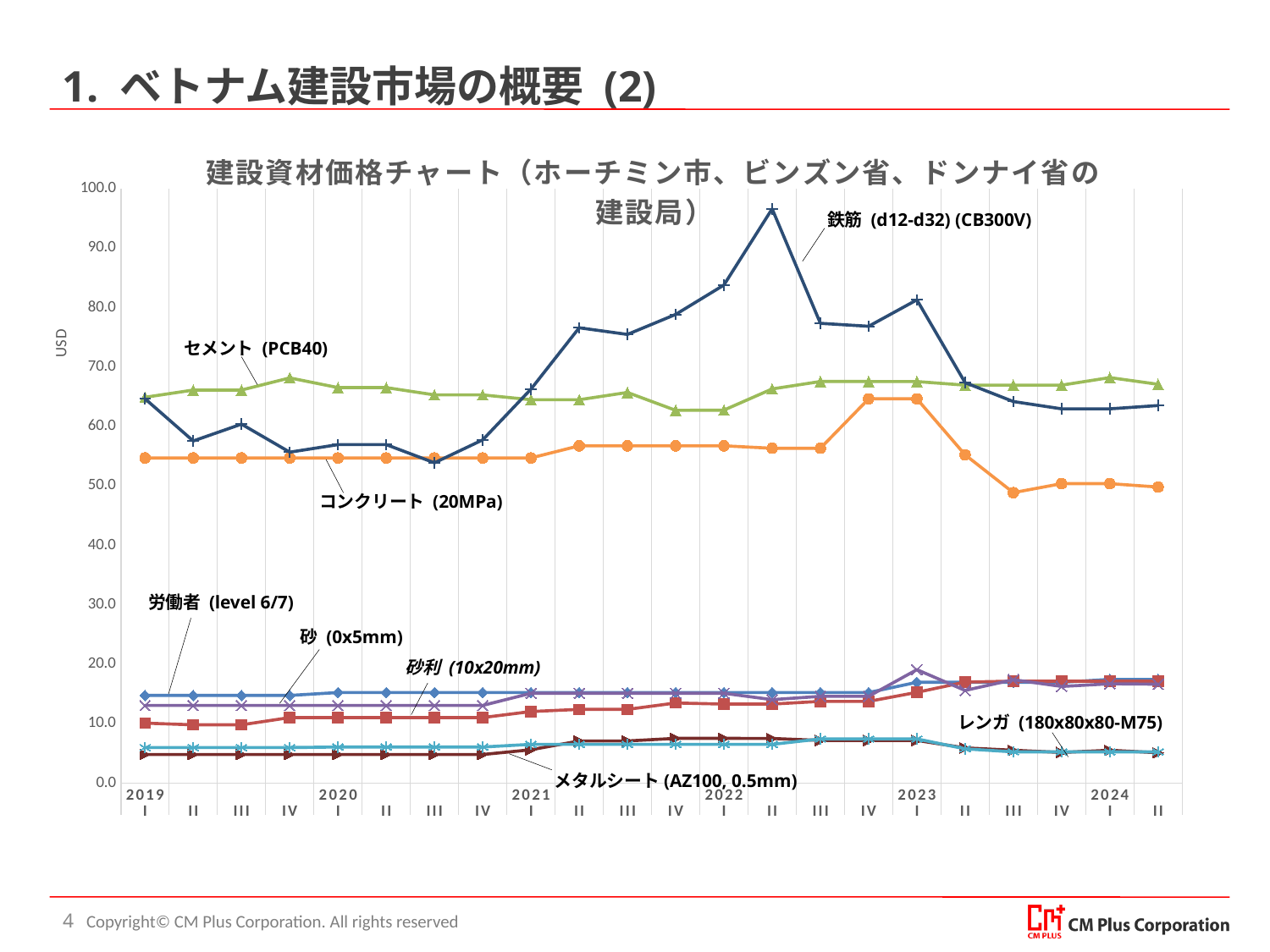
Does the value for 鉄筋 (d12-d32) (CB300V) rise or fall from 2021 I to 2022 II? rise Is the value for 鉄筋 (d12-d32) (CB300V) in 2022 II greater or less than 90? greater What unit is shown on the vertical axis of the chart? USD In 2019 I, which is larger: セメント (PCB40) or コンクリート (20MPa)? セメント (PCB40) What kind of chart is shown on the slide? Line chart Is the value for コンクリート (20MPa) in 2023 I greater or less than 60? greater What is the title of the chart? 建設資材価格チャート（ホーチミン市、ビンズン省、ドンナイ省の建設局） How many quarterly points are plotted along the x axis, from 2019 I to 2024 II? 22 In which quarter does 鉄筋 (d12-d32) (CB300V) reach its highest value? 2022 II How many labeled series are plotted on the chart? 8 Which series reaches the highest value anywhere on the chart? 鉄筋 (d12-d32) (CB300V) Is the value for メタルシート (AZ100, 0.5mm) in 2019 I greater or less than 10? less